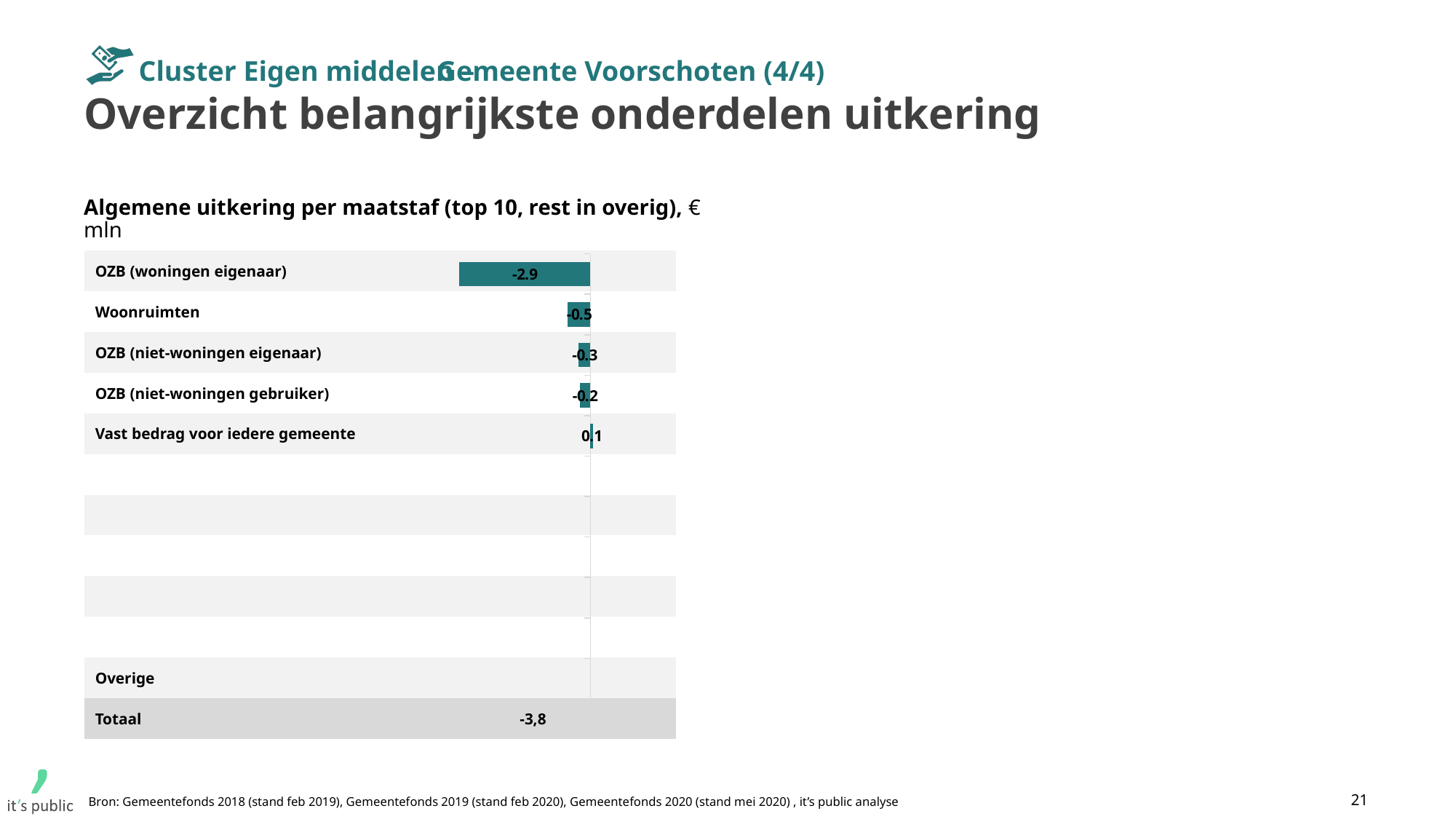
What is the value for Woonruimten? -0.5 What is the value for Vast bedrag voor iedere gemeente? 0.1 Which is larger, the value for OZB (niet-woningen gebruiker) or the value for Woonruimten? OZB (niet-woningen gebruiker) What is the value for OZB (niet-woningen eigenaar)? -0.3 Which category has the highest value? Vast bedrag voor iedere gemeente What is the title of the chart? Algemene uitkering per maatstaf (top 10, rest in overig), € mln How many categories have a bar with a printed value in the chart? 5 Which category has the lowest (most negative) value? OZB (woningen eigenaar) What is the value for OZB (woningen eigenaar)? -2.9 What kind of chart is shown on the slide? Bar chart What is the difference between the values for OZB (woningen eigenaar) and Woonruimten? 2.4 What is the value shown for Totaal? -3,8